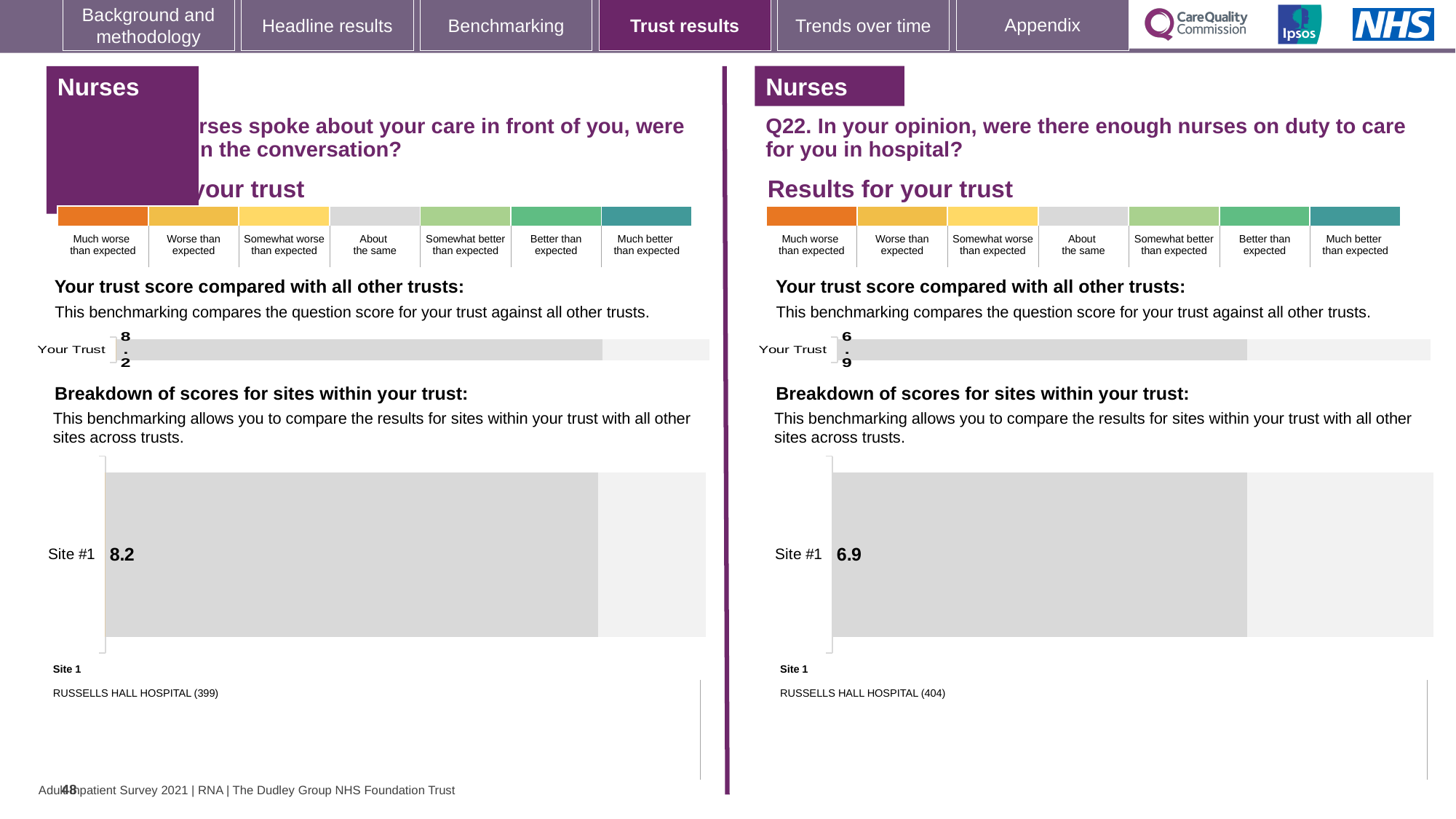
On the left-hand panel, what is the score shown for Your Trust? 8.2 On the left-hand panel, what is the name of the site labelled Site 1? RUSSELLS HALL HOSPITAL (399) On the left-hand panel, what is the score shown for Site #1? 8.2 On the right-hand panel (Q22), what is the score shown for Your Trust? 6.9 How many sites are shown in the site breakdown chart on the left-hand panel? 1 How many sites are shown in the site breakdown chart on the right-hand panel (Q22)? 1 What is the difference between the Site #1 score on the left-hand panel (8.2) and the Site #1 score on the right-hand panel (6.9)? 1.3 On the right-hand panel (Q22), what is the score shown for Site #1? 6.9 On the right-hand panel (Q22), what is the name of the site labelled Site 1? RUSSELLS HALL HOSPITAL (404) What kind of chart is used to show the Site #1 score on the right-hand panel (Q22)? bar chart Which is larger: the Site #1 score on the left-hand panel or the Site #1 score on the right-hand panel (Q22)? Left-hand panel (8.2)